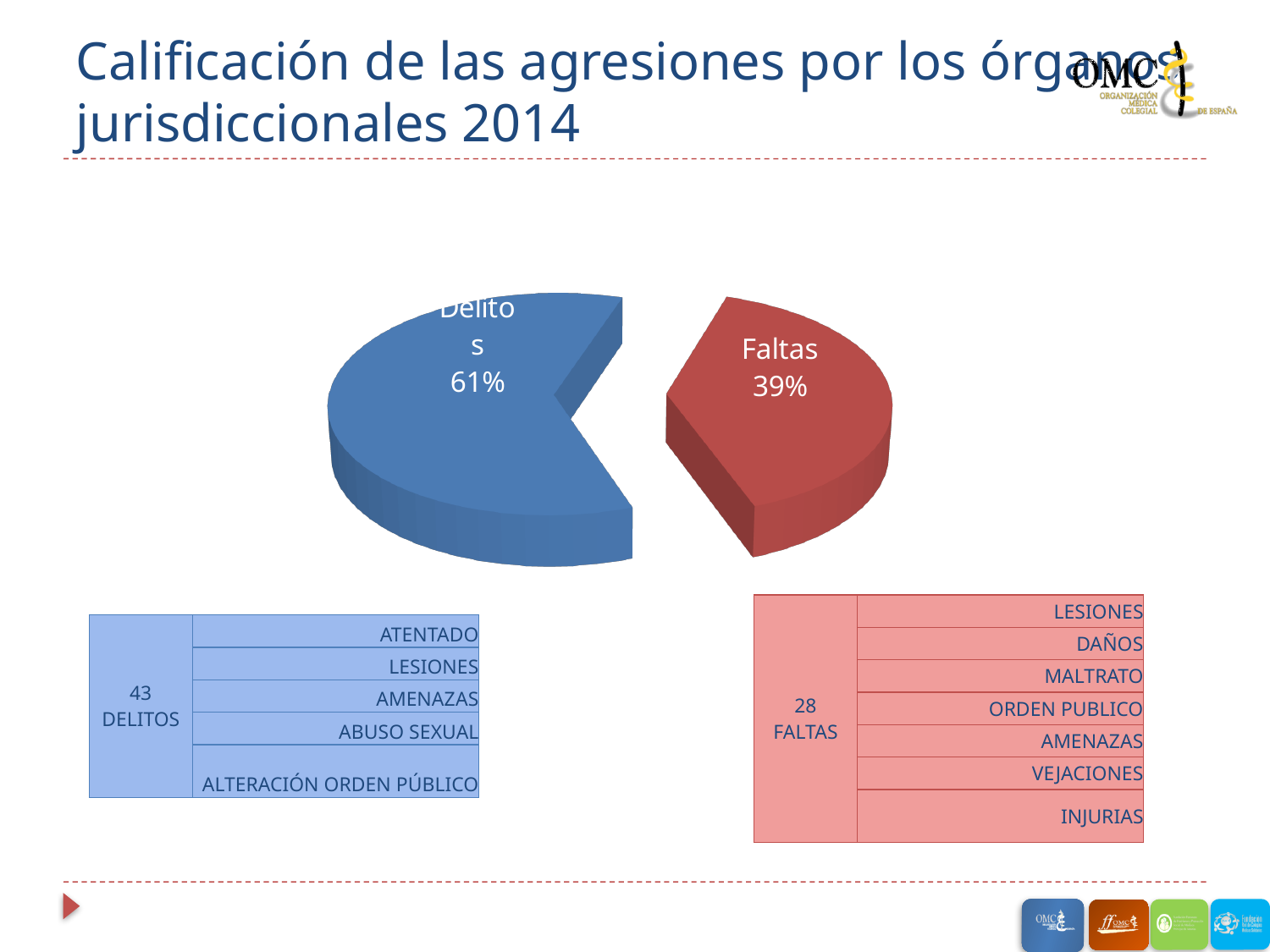
What percentage of the pie chart is Faltas? 39% What kind of chart is shown on the slide? pie chart Which slice of the pie chart is the largest? Delitos What colour is the Faltas slice of the pie chart? red How many slices does the pie chart have? 2 What colour is the Delitos slice of the pie chart? blue Which is larger in the pie chart, Delitos or Faltas? Delitos Which slice of the pie chart is the smallest? Faltas What percentage of the pie chart is Delitos? 61% What is the difference in percentage points between the Delitos and Faltas slices? 22 What share of the pie does the Faltas slice represent? 39%